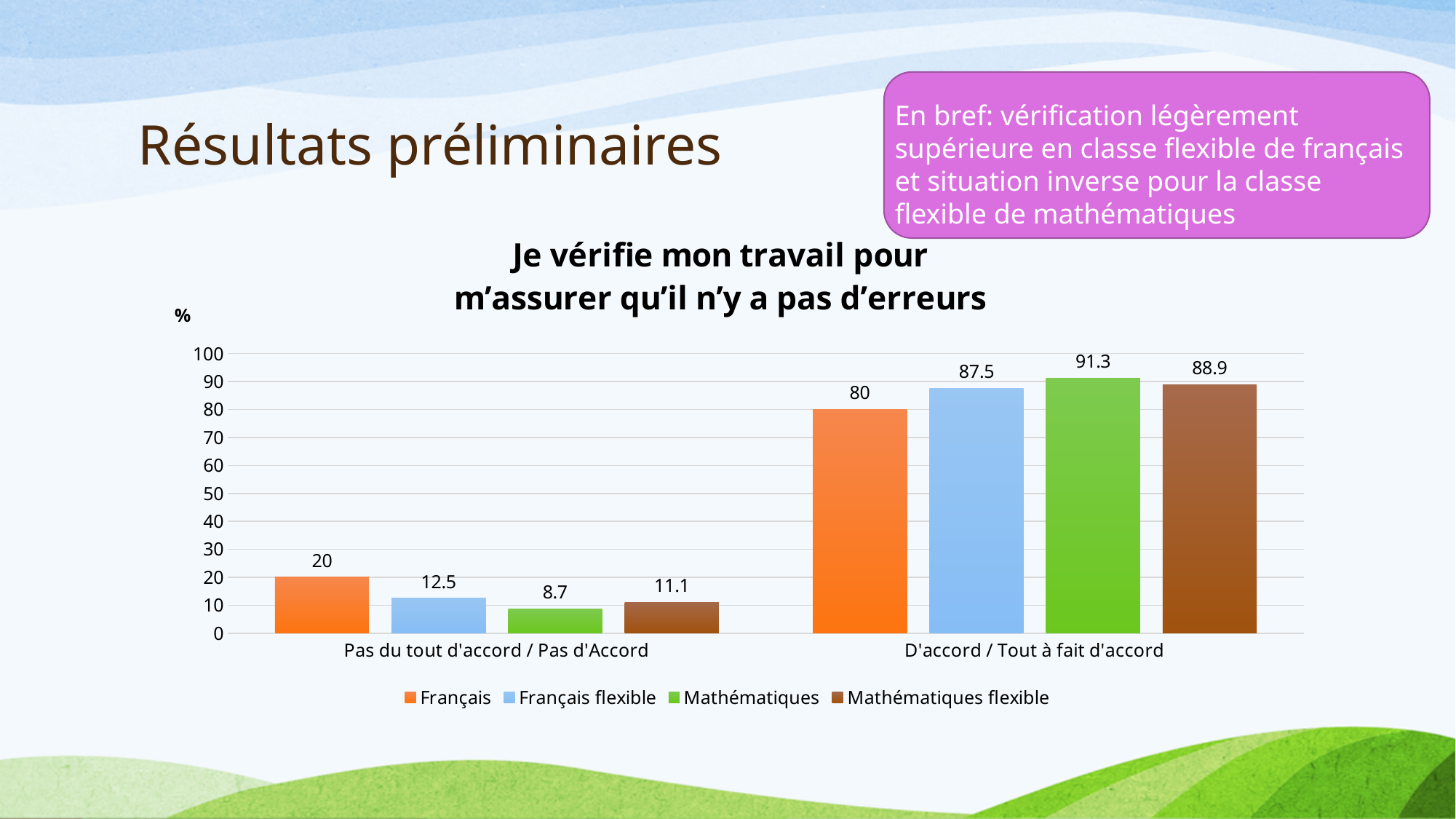
What kind of chart is shown on the slide? Bar chart Is the value for Mathématiques flexible in the 'D'accord / Tout à fait d'accord' category greater or less than 80? greater What is the value for Français flexible in the 'D'accord / Tout à fait d'accord' category? 87.5 Which series has the lowest value in the 'Pas du tout d'accord / Pas d'Accord' category? Mathématiques In the 'Pas du tout d'accord / Pas d'Accord' category, which is larger: Français flexible or Mathématiques flexible? Français flexible What is the title of the chart? Je vérifie mon travail pour m'assurer qu'il n'y a pas d'erreurs What is the value for Mathématiques flexible in the 'Pas du tout d'accord / Pas d'Accord' category? 11.1 Which series has the highest value in the 'D'accord / Tout à fait d'accord' category? Mathématiques What is the value for Français in the 'Pas du tout d'accord / Pas d'Accord' category? 20 How many series does the legend list? 4 What is the difference between the Français flexible and Français values in the 'D'accord / Tout à fait d'accord' category? 7.5 What is the value for Mathématiques in the 'D'accord / Tout à fait d'accord' category? 91.3